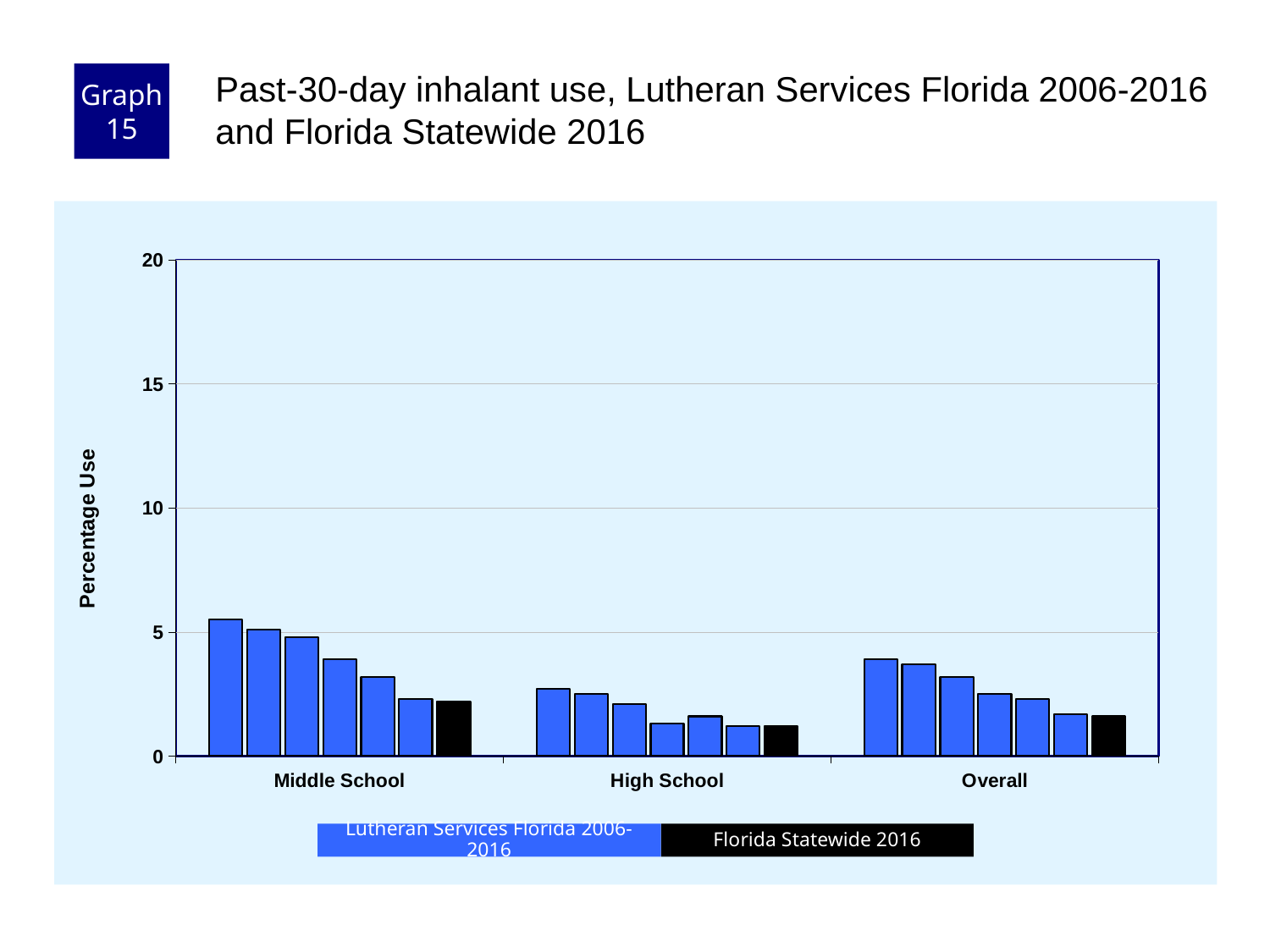
How many bars are plotted in the Middle School group? 7 Which category group contains the tallest bar on the chart? Middle School Is the Florida Statewide 2016 value for High School greater or less than 5? less How many categories are shown on the x axis? 3 Which category group has the lowest bars overall? High School Do the Lutheran Services Florida bars in the Middle School group rise or fall from left to right? fall Is the tallest bar in the Middle School group greater or less than 5? greater What is the label on the y axis? Percentage Use What kind of chart is shown on the slide? bar chart Is the tallest bar in the Overall group greater or less than 5? less How many series does the legend list? 2